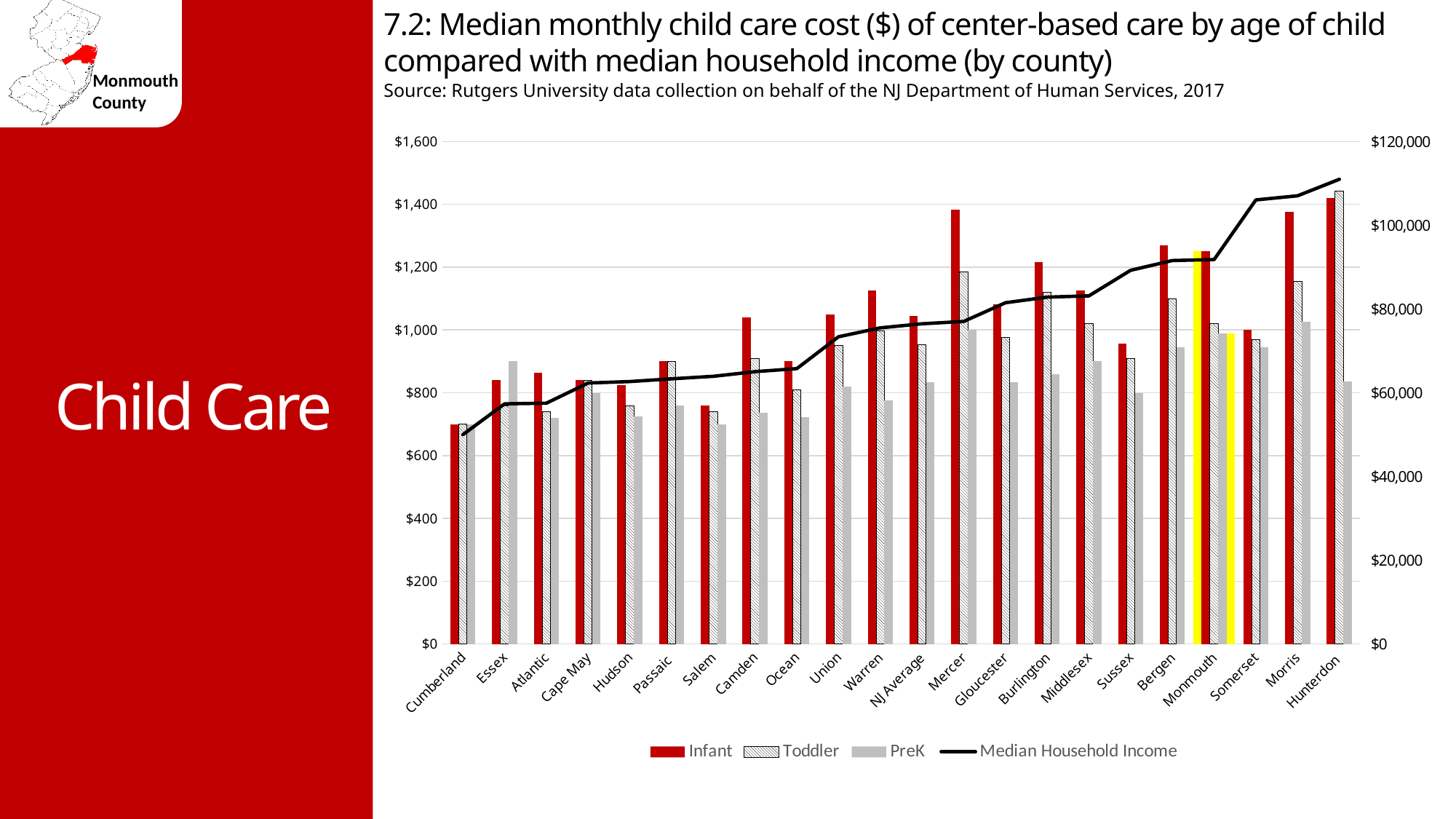
Which county has the lowest Infant cost? Cumberland Which county has the highest Toddler cost? Hunterdon How many categories are shown on the x axis of the chart? 22 Is the Infant value for Mercer greater or less than $1,200? greater What kind of chart is shown on the slide? Bar chart with a line Is the Infant value for Cumberland greater or less than $800? less For Mercer, which is larger: the Infant cost or the PreK cost? Infant Is the Median Household Income for Cumberland greater or less than $60,000? less Does the Median Household Income line generally rise or fall from left to right across the counties? rise How many series does the chart legend list? 4 Which county's bars are highlighted in yellow on the chart? Monmouth